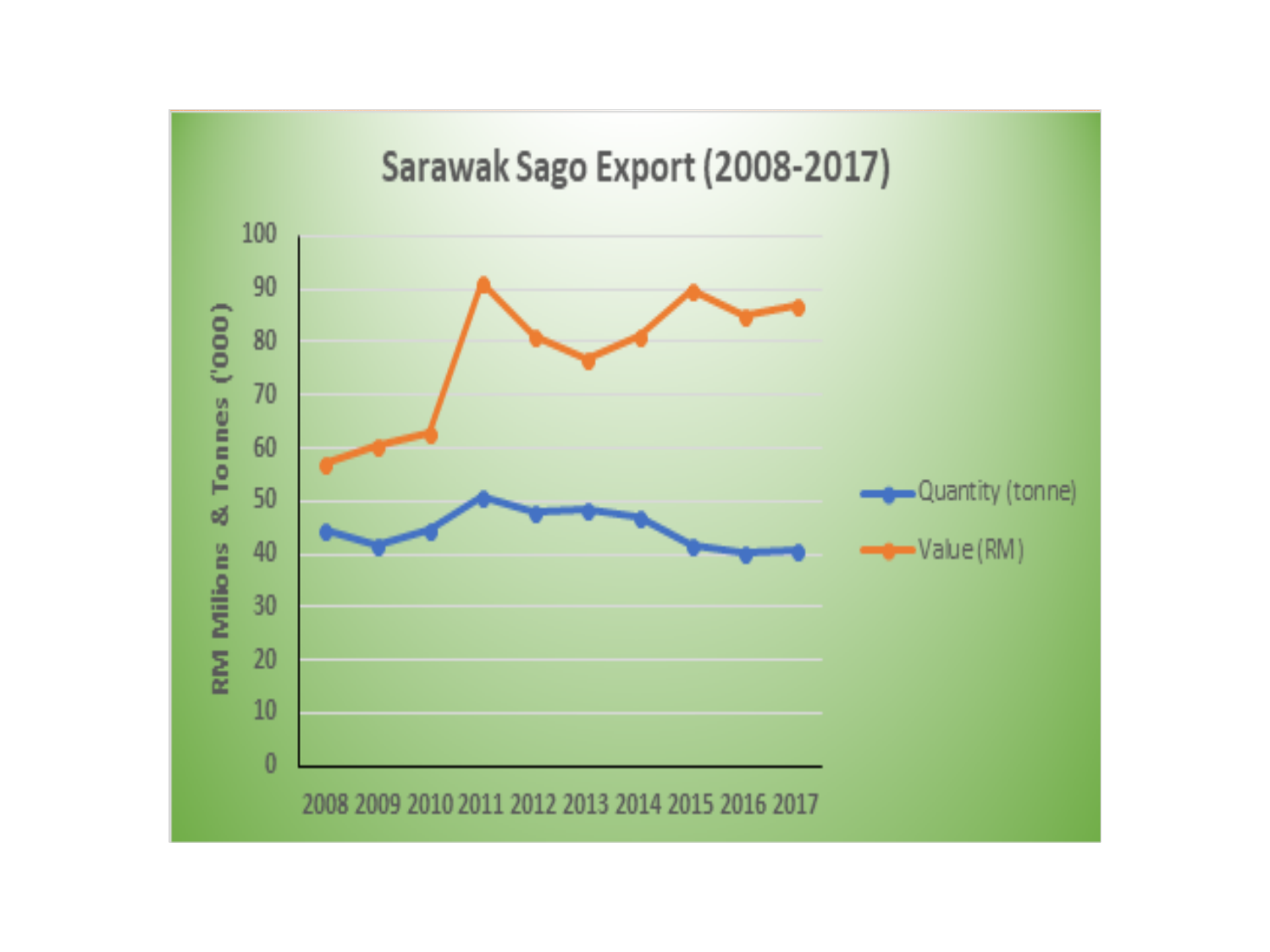
How many series does the legend list? 2 Which colour is used for the Value (RM) series? Orange Does the Value (RM) series rise or fall from 2008 to 2011? Rise Which is larger, the Value (RM) in 2010 or in 2011? 2011 Is the Quantity (tonne) for 2011 greater or less than 40? greater What type of chart is shown on the slide? Line chart Is the Value (RM) for 2011 greater or less than 80? greater How many years are plotted along the x axis? 10 Is the Quantity (tonne) for 2016 greater or less than 50? less What is the title of the chart? Sarawak Sago Export (2008-2017) In which year is the Value (RM) lowest? 2008